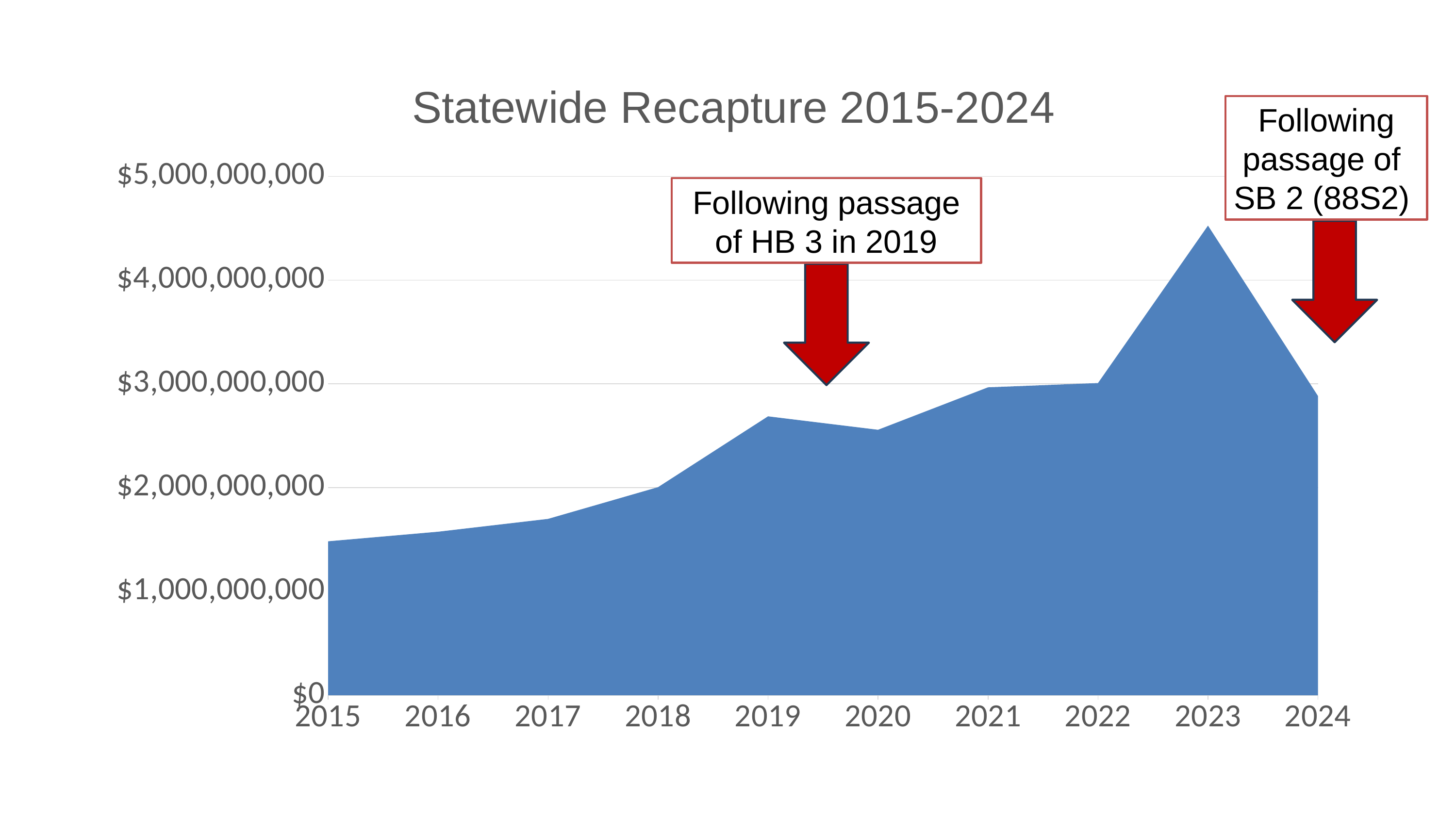
Which year has the larger value, 2019 or 2023? 2023 Which year has the lowest statewide recapture value? 2015 Is the value for 2019 greater or less than $2,000,000,000? greater How many years are plotted along the x axis? 10 Which year has the highest statewide recapture value? 2023 What does the annotation pointing at 2023-2024 say? Following passage of SB 2 (88S2) Is the value for 2015 greater or less than $1,000,000,000? greater Is the value for 2015 greater or less than $2,000,000,000? less What kind of chart is shown on the slide? Area chart Do the values rise or fall from 2015 to 2019? rise What is the title of the chart? Statewide Recapture 2015-2024